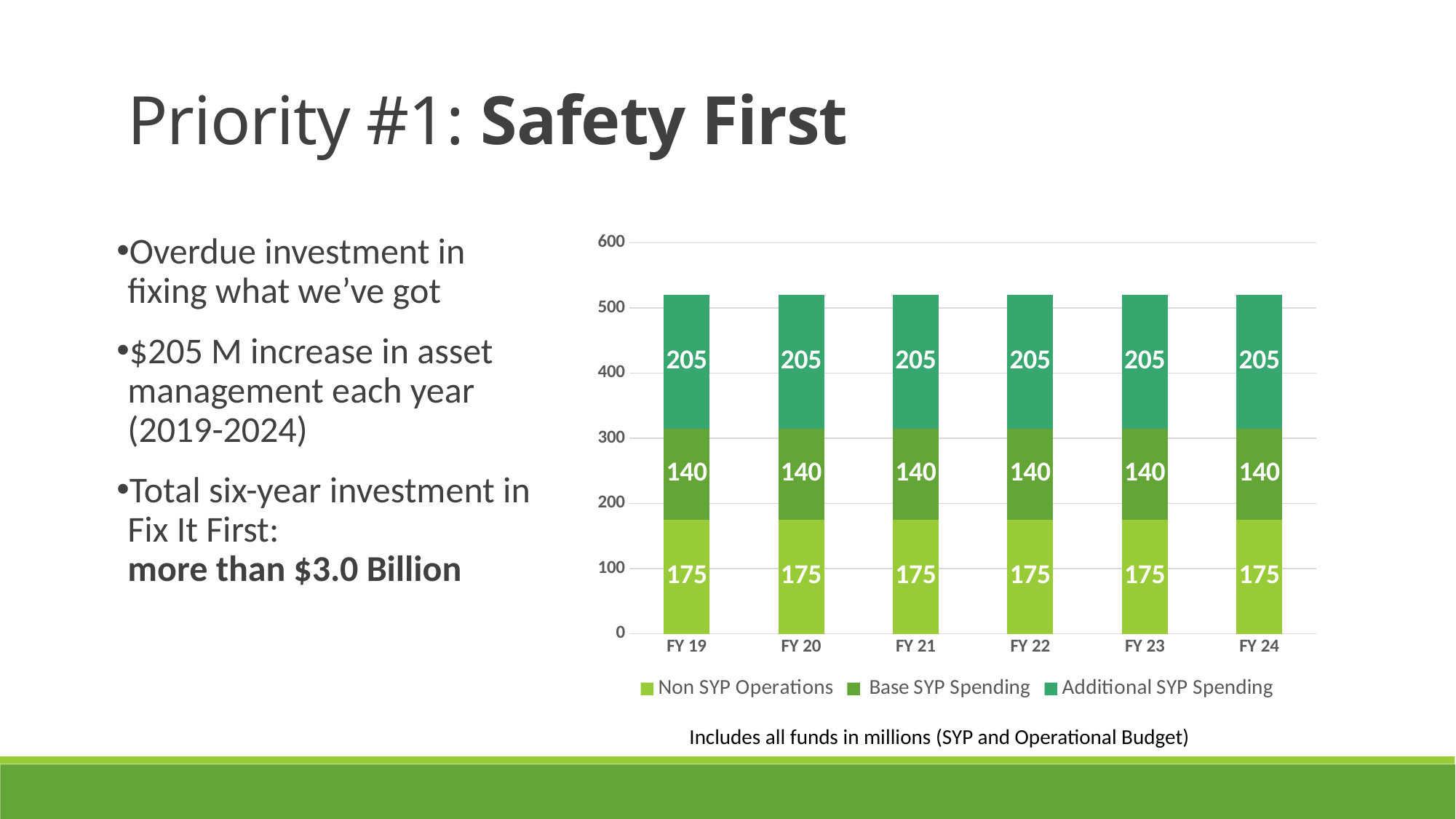
Do the total bar heights rise, fall, or stay the same from FY 19 to FY 24? Stay the same What is the value of Additional SYP Spending for FY 24? 205 What kind of chart is shown on the slide? Stacked bar chart What is the value of Base SYP Spending for FY 22? 140 How many series does the legend list? 3 What is the total of the stacked bar for FY 21? 520 What is the difference between Additional SYP Spending and Base SYP Spending in FY 20? 65 Which is larger in FY 23: Non SYP Operations or Base SYP Spending? Non SYP Operations Which series has the smallest value in FY 24? Base SYP Spending Which series has the largest value in FY 19? Additional SYP Spending How many fiscal years are shown on the x axis? 6 What is the value of Non SYP Operations for FY 19? 175